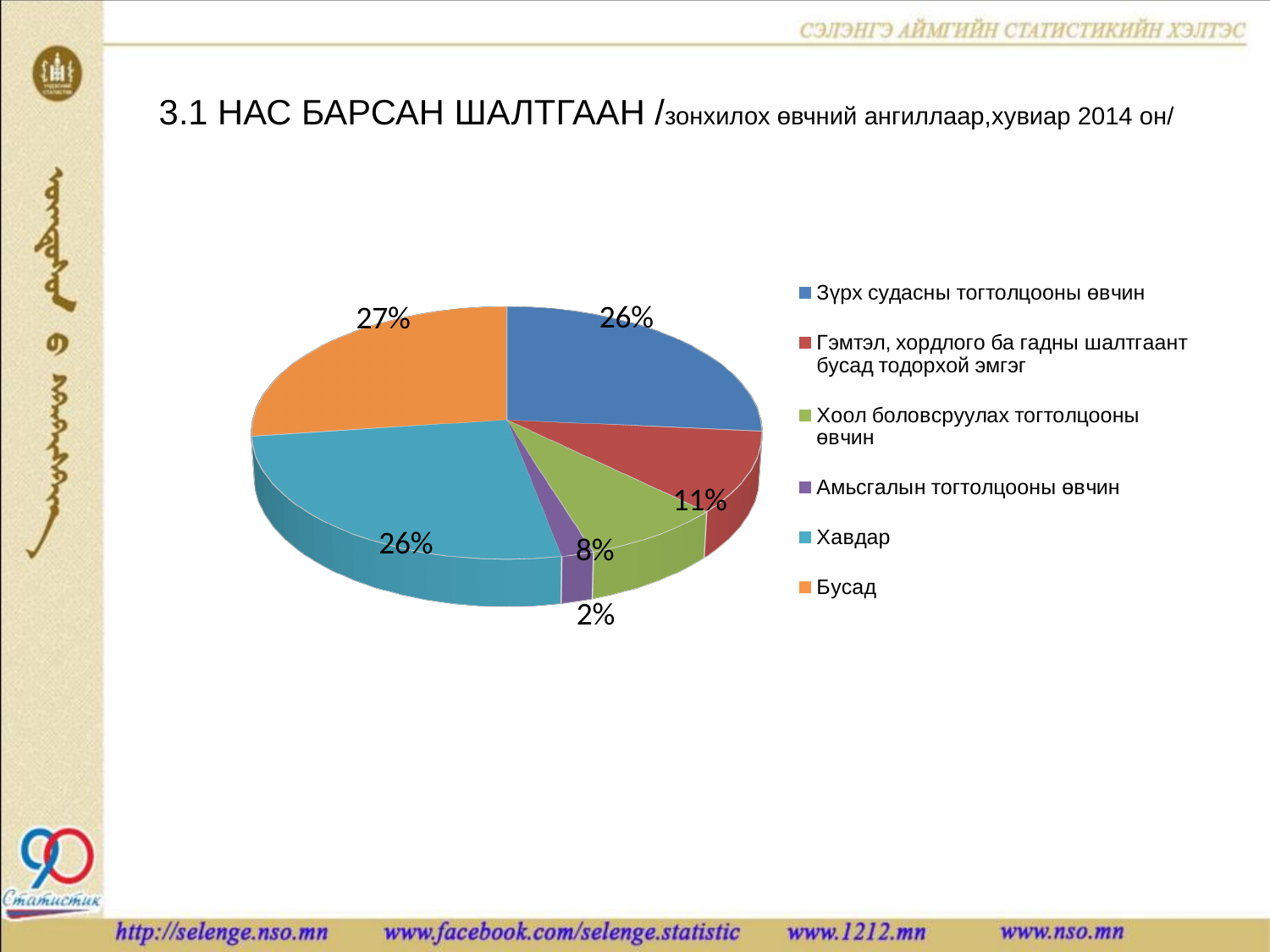
Which category has the smallest share of the pie? Амьсгалын тогтолцооны өвчин What percentage is shown for Хоол боловсруулах тогтолцооны өвчин? 8% What is the difference in percentage points between Гэмтэл, хордлого ба гадны шалтгаант бусад тодорхой эмгэг and Хоол боловсруулах тогтолцооны өвчин? 3 percentage points Which category has the largest share of the pie? Бусад How many categories does the legend list? 6 What share of deaths is attributed to Зүрх судасны тогтолцооны өвчин? 26% What percentage is shown for Бусад? 27% What percentage is shown for Амьсгалын тогтолцооны өвчин? 2% What percentage is shown for Гэмтэл, хордлого ба гадны шалтгаант бусад тодорхой эмгэг? 11% Which is larger, the share for Хавдар or the share for Гэмтэл, хордлого ба гадны шалтгаант бусад тодорхой эмгэг? Хавдар What percentage is shown for Хавдар? 26% What kind of chart is shown on the slide? pie chart